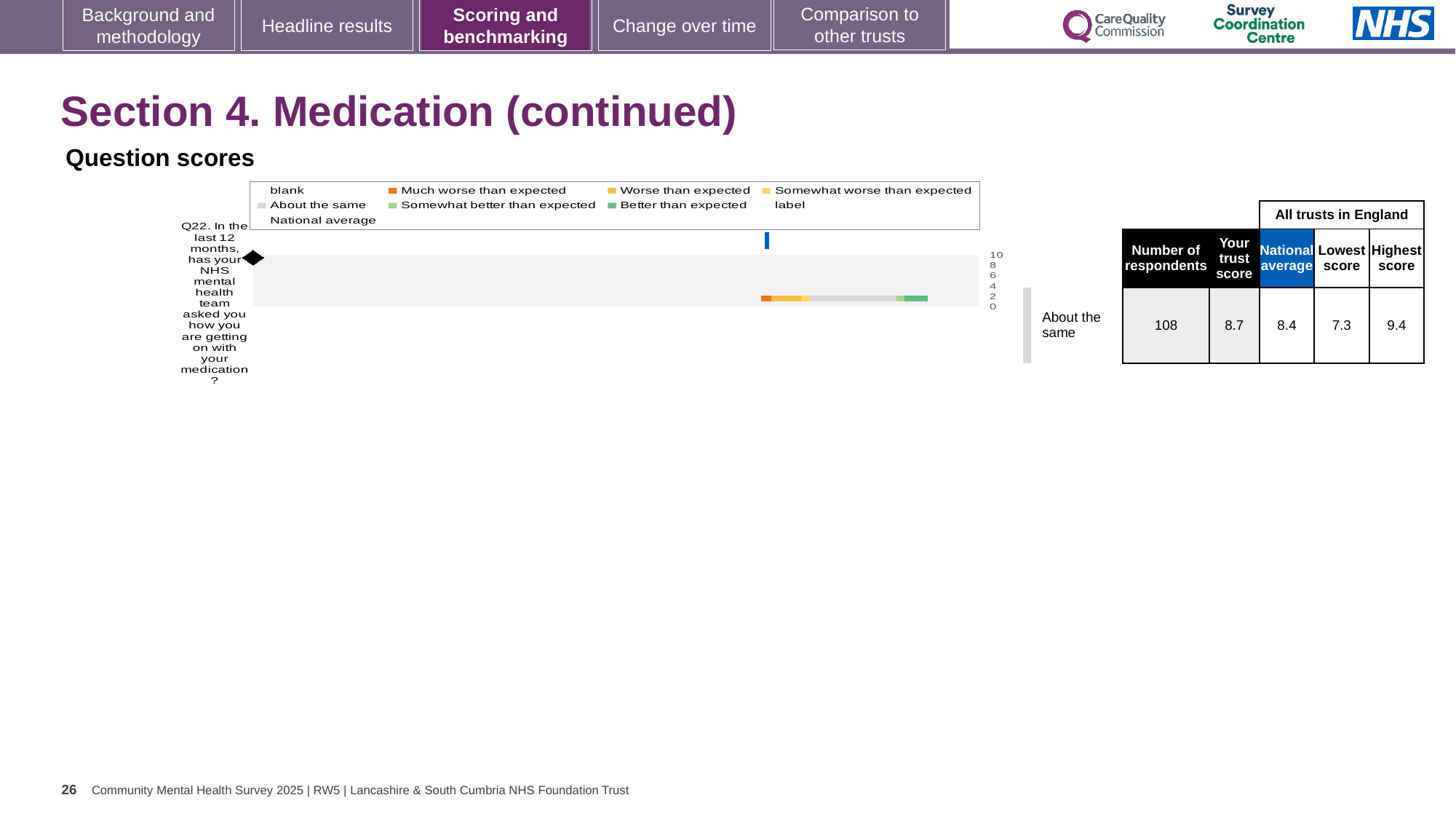
In the legend of the Question scores chart, what colour represents 'Much worse than expected'? orange What kind of chart is shown under 'Question scores'? bar chart In the table beside the Question scores chart, what is the Number of respondents for Q22? 108 For Q22, what is the difference between the Highest score and the Lowest score among all trusts in England? 2.1 What benchmark category is shown for Q22 next to the Question scores chart? About the same In the table beside the Question scores chart, what is the Highest score among all trusts in England for Q22? 9.4 In the table beside the Question scores chart, what is the National average for Q22? 8.4 How many questions (categories) are plotted in the Question scores chart? 1 In the table beside the Question scores chart, what is the 'Your trust score' for Q22? 8.7 How many entries does the legend of the Question scores chart list? 9 For Q22, which is larger: the trust score or the National average? the trust score In the table beside the Question scores chart, what is the Lowest score among all trusts in England for Q22? 7.3